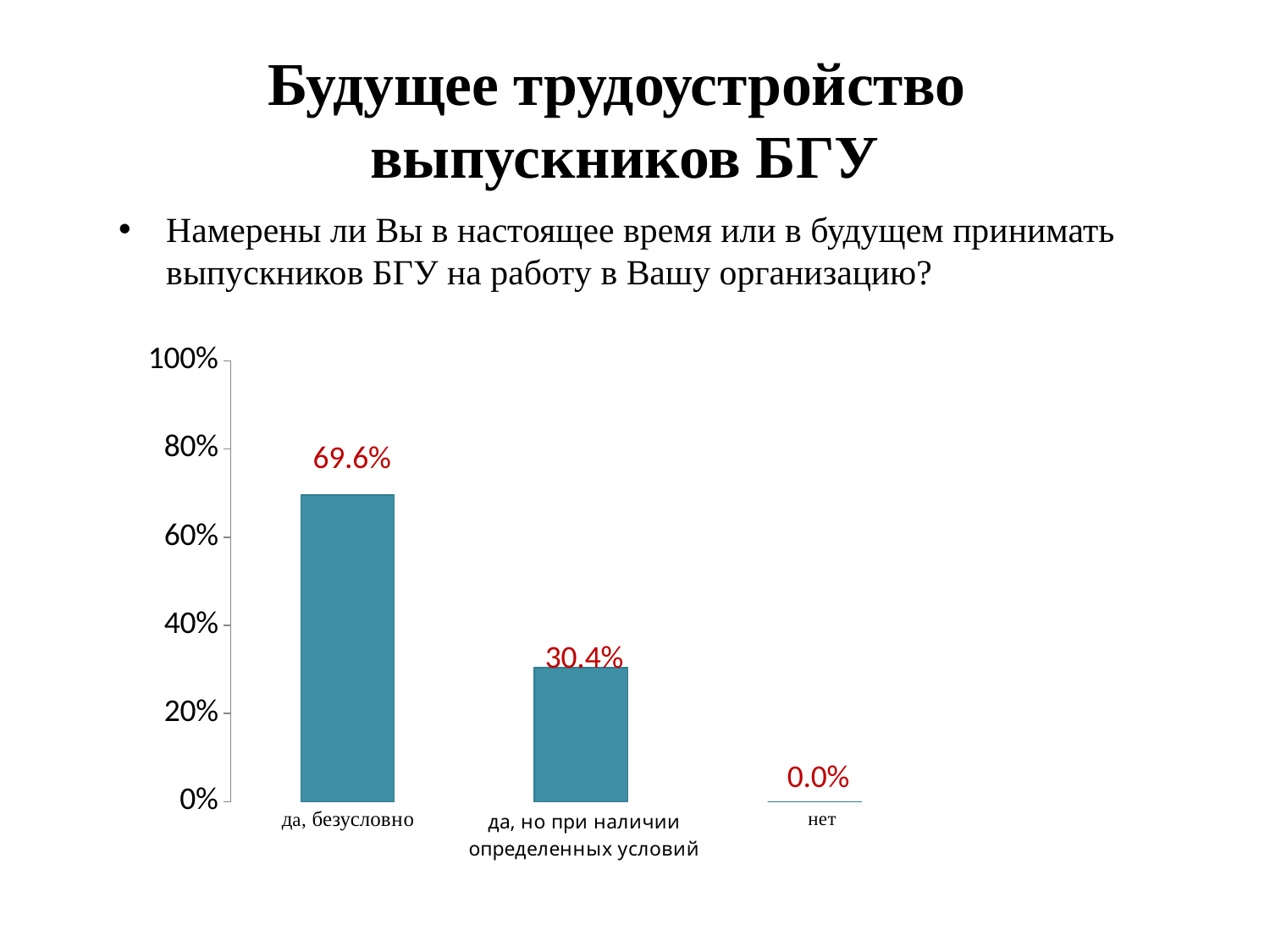
What is the value for "да, но при наличии определенных условий"? 30.4% Which category has the highest value? да, безусловно Which is larger: the value for "да, безусловно" or the value for "да, но при наличии определенных условий"? да, безусловно How many categories are shown on the chart? 3 Do the values rise or fall from left to right along the x axis? fall What is the value for "нет"? 0.0% Is the value for "да, но при наличии определенных условий" greater or less than 40%? less Is the value for "да, безусловно" greater or less than 60%? greater Which category has the lowest value? нет What is the value for "да, безусловно"? 69.6% What is the difference between the values for "да, безусловно" and "да, но при наличии определенных условий"? 39.2% What kind of chart is shown on the slide? bar chart